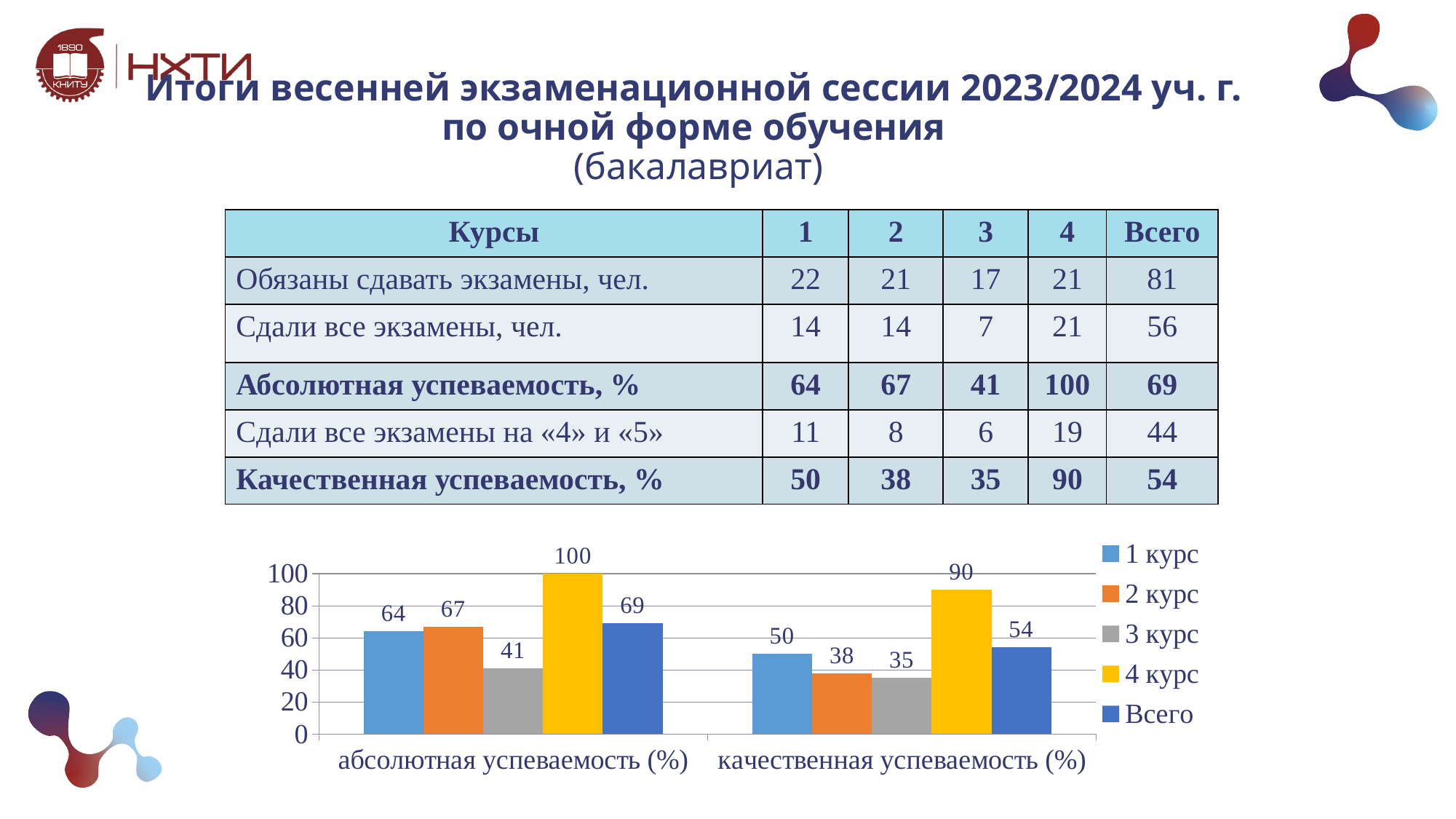
What kind of chart is shown on the slide? bar chart How many categories are shown on the x axis of the chart? 2 Which series has the lowest value in the абсолютная успеваемость (%) category? 3 курс What is the value for 4 курс in the абсолютная успеваемость (%) category? 100 How many series does the chart legend list? 5 Is the value for 2 курс in the качественная успеваемость (%) category greater or less than 40? less Which is larger in the абсолютная успеваемость (%) category: 1 курс or 2 курс? 2 курс What is the value for 3 курс in the качественная успеваемость (%) category? 35 What is the difference between the 4 курс and 3 курс values in the качественная успеваемость (%) category? 55 What colour are the bars for 4 курс in the chart? yellow What is the value for Всего in the абсолютная успеваемость (%) category? 69 Which series has the highest value in the качественная успеваемость (%) category? 4 курс